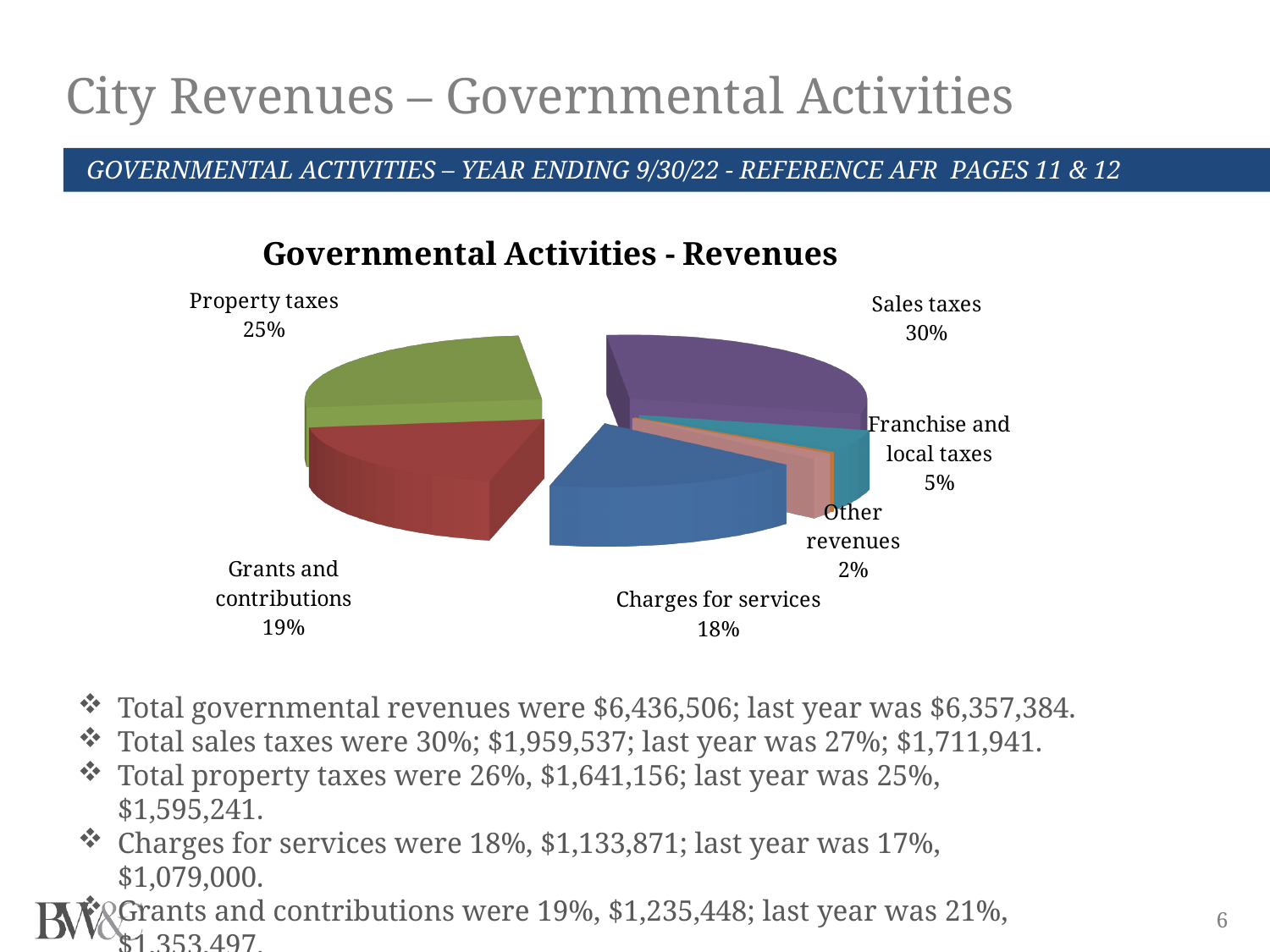
What is the title of the chart? Governmental Activities - Revenues Which is larger, the share for Grants and contributions or the share for Charges for services? Grants and contributions What share of the pie is Property taxes? 25% Which category has the largest share of the pie? Sales taxes What share of the pie is Franchise and local taxes? 5% What share of the pie is Grants and contributions? 19% What kind of chart is shown on the slide? Pie chart What is the difference in percentage points between Sales taxes and Property taxes? 5 percentage points How many slices does the pie chart have? 7